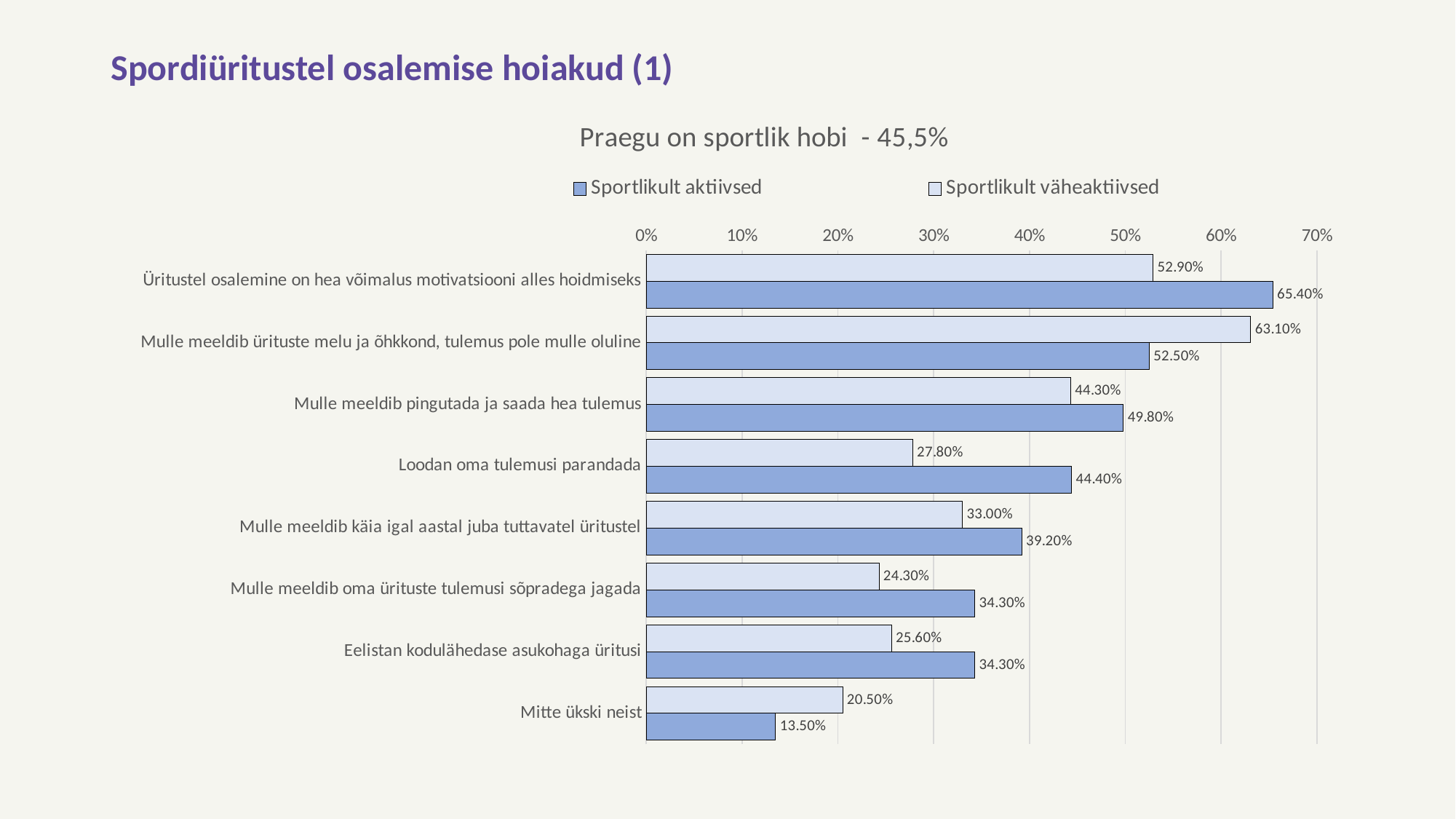
What is the value for "Sportlikult aktiivsed" for "Üritustel osalemine on hea võimalus motivatsiooni alles hoidmiseks"? 65.40% What is the value for "Sportlikult väheaktiivsed" for "Loodan oma tulemusi parandada"? 27.80% What is the value for "Sportlikult väheaktiivsed" for "Mulle meeldib ürituste melu ja õhkkond, tulemus pole mulle oluline"? 63.10% What kind of chart is shown on the slide? Bar chart Is the "Sportlikult aktiivsed" value for "Mulle meeldib pingutada ja saada hea tulemus" greater or less than 40%? greater For "Mitte ükski neist", which series has the larger value: "Sportlikult aktiivsed" or "Sportlikult väheaktiivsed"? Sportlikult väheaktiivsed How many series does the legend list? 2 Which category has the lowest value for "Sportlikult väheaktiivsed"? Mitte ükski neist What is the difference between the "Sportlikult aktiivsed" and "Sportlikult väheaktiivsed" values for "Loodan oma tulemusi parandada"? 16.60% Which category has the highest value for "Sportlikult aktiivsed"? Üritustel osalemine on hea võimalus motivatsiooni alles hoidmiseks How many categories are shown on the chart? 8 What is the title of the chart? Praegu on sportlik hobi - 45,5%